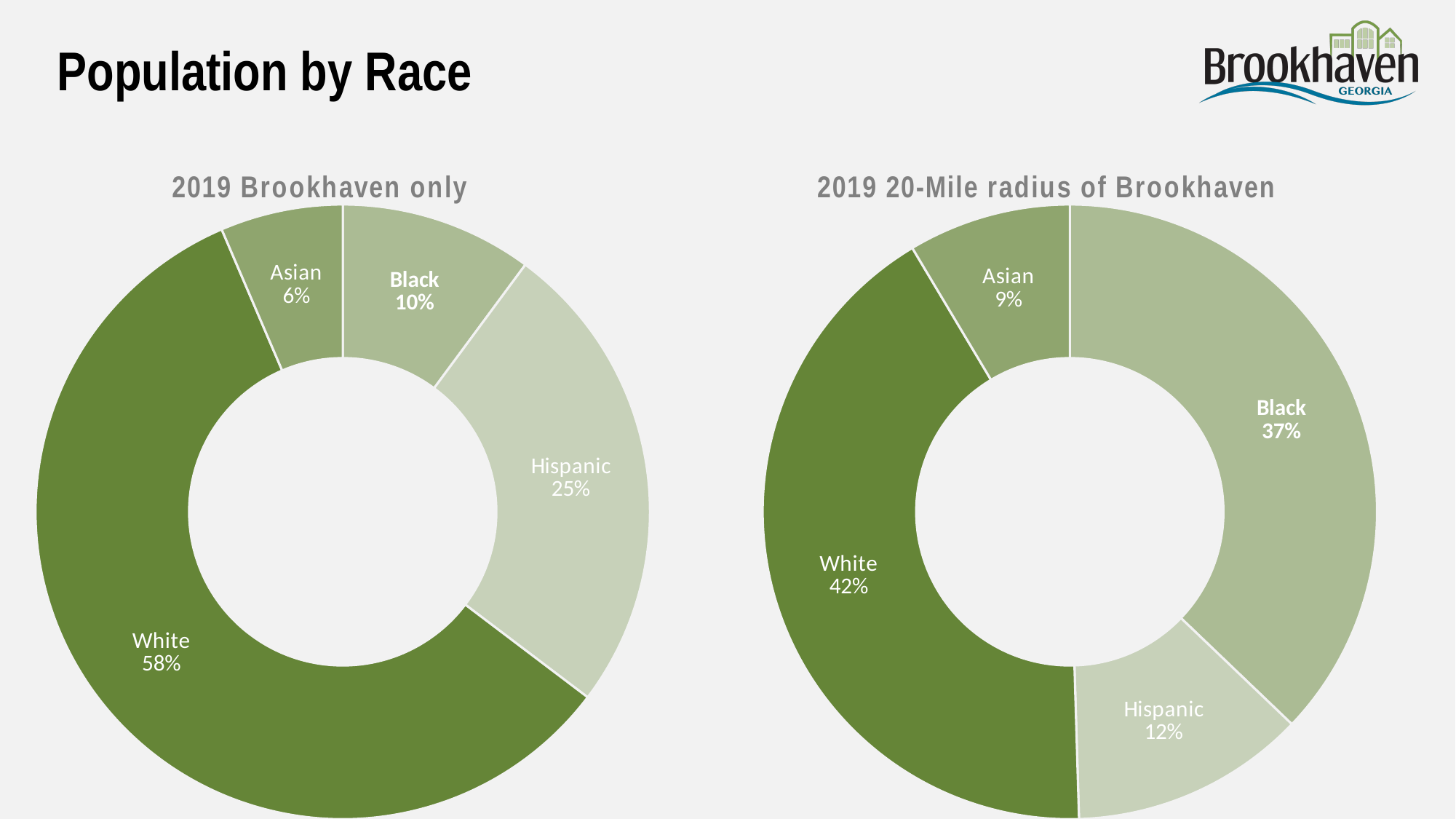
What type of chart is used on this slide? Doughnut (pie) chart In the '2019 Brookhaven only' chart, which race has the smallest share? Asian In the '2019 20-Mile radius of Brookhaven' chart, what share of the population is Asian? 9% In the '2019 20-Mile radius of Brookhaven' chart, which race has the smallest share? Asian In the '2019 20-Mile radius of Brookhaven' chart, what share of the population is Black? 37% How many race categories are shown in the '2019 Brookhaven only' chart? 4 In the '2019 20-Mile radius of Brookhaven' chart, which is larger, the Hispanic share or the Asian share? Hispanic In the '2019 20-Mile radius of Brookhaven' chart, what is the difference between the White and Black shares? 5% In the '2019 Brookhaven only' chart, which race has the largest share? White In the '2019 Brookhaven only' chart, what share of the population is Hispanic? 25% In the '2019 Brookhaven only' chart, what is the difference between the Hispanic and Black shares? 15% In the '2019 Brookhaven only' chart, what share of the population is White? 58%